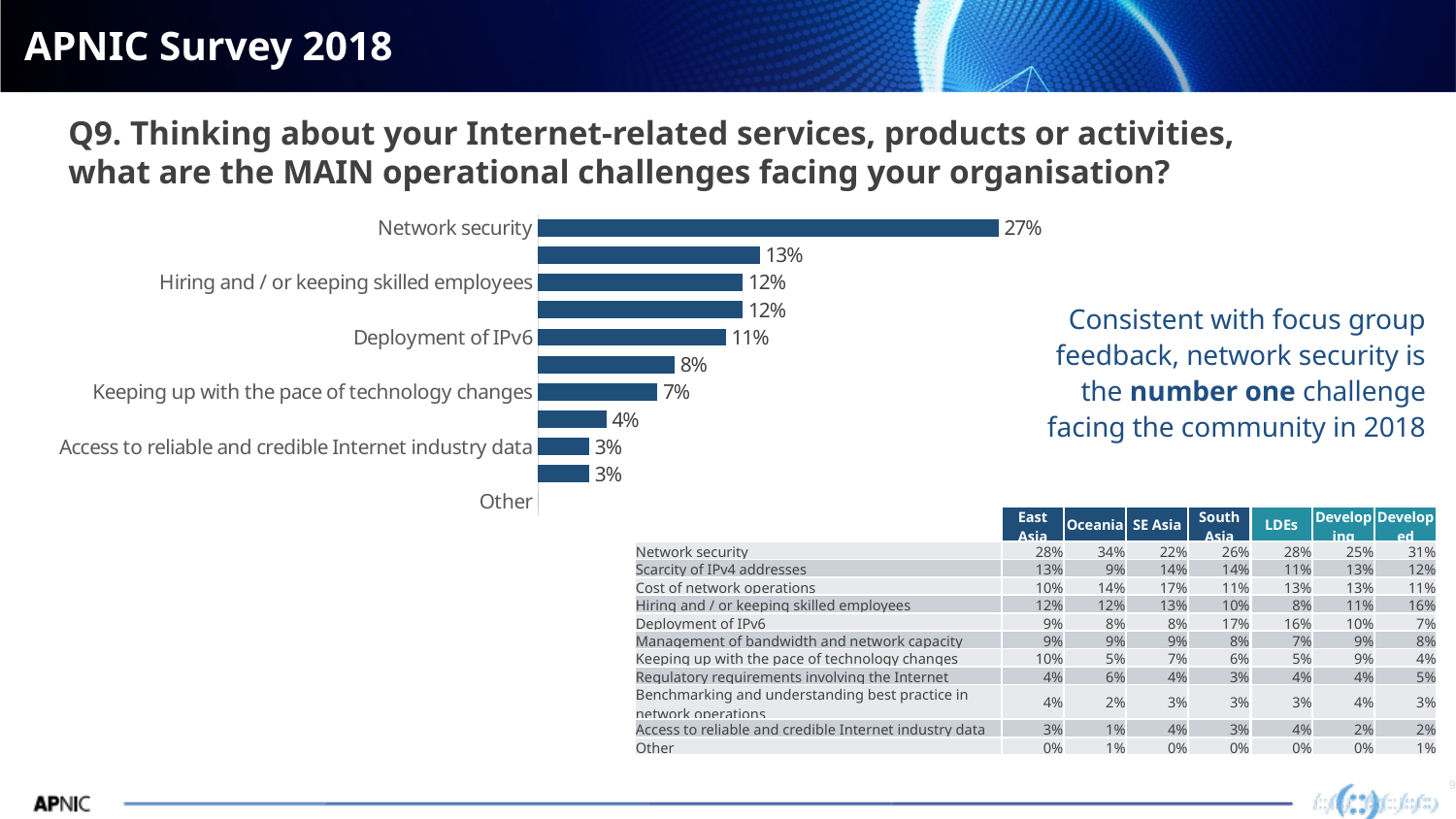
What value does the bar chart show for Hiring and / or keeping skilled employees? 12% What percentage is shown for Network security in the bar chart? 27% What type of chart is used to show the operational challenges on this slide? Bar chart Which labelled category has the highest value in the bar chart? Network security What is the largest value labelled on the bar chart? 27% What percentage is shown for Deployment of IPv6 in the bar chart? 11% How much higher is Network security than Hiring and / or keeping skilled employees in the bar chart? 15 percentage points What value does the bar chart give for Keeping up with the pace of technology changes? 7% What percentage is shown for Access to reliable and credible Internet industry data? 3% What is the difference between Network security and Access to reliable and credible Internet industry data in the bar chart? 24 percentage points What is the difference between Deployment of IPv6 and Keeping up with the pace of technology changes in the bar chart? 4 percentage points Which is larger in the bar chart: Hiring and / or keeping skilled employees or Deployment of IPv6? Hiring and / or keeping skilled employees